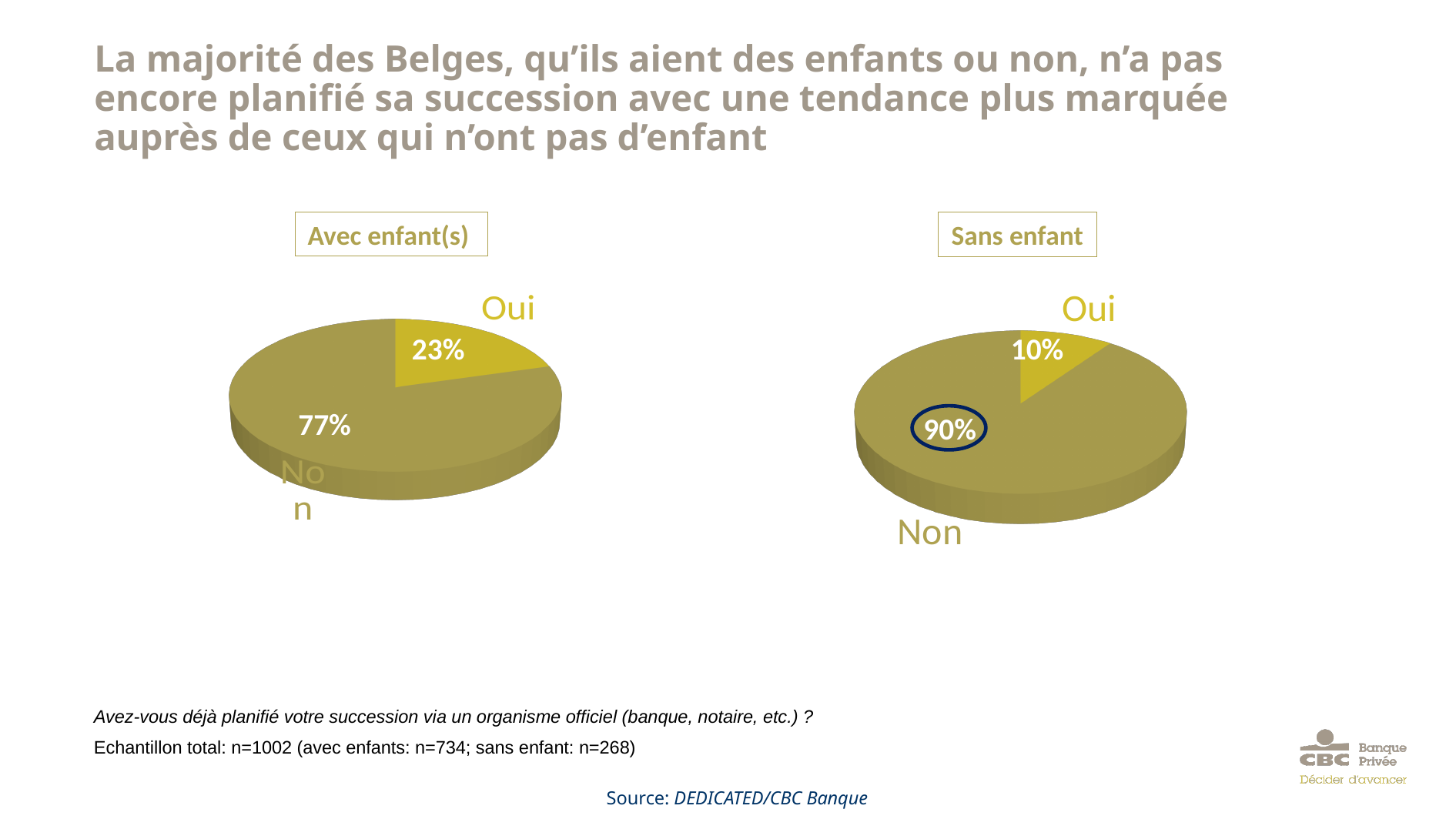
In the 'Sans enfant' pie chart, which value is circled? 90% In the 'Avec enfant(s)' pie chart, which slice is the smallest? Oui What is the difference between the 'Non' share in the 'Sans enfant' chart and the 'Non' share in the 'Avec enfant(s)' chart? 13 percentage points In the 'Avec enfant(s)' pie chart, what percentage answered 'Non'? 77% In the 'Sans enfant' pie chart, what percentage answered 'Non'? 90% How many slices does the 'Avec enfant(s)' pie chart have? 2 In the 'Sans enfant' pie chart, which slice is the largest? Non How many pie charts are shown on the slide? 2 In the 'Sans enfant' pie chart, what percentage answered 'Oui'? 10% What type of chart is used on this slide? Pie chart In the 'Avec enfant(s)' pie chart, what percentage answered 'Oui'? 23% Which is larger: the 'Oui' share in the 'Avec enfant(s)' chart or the 'Oui' share in the 'Sans enfant' chart? Avec enfant(s)